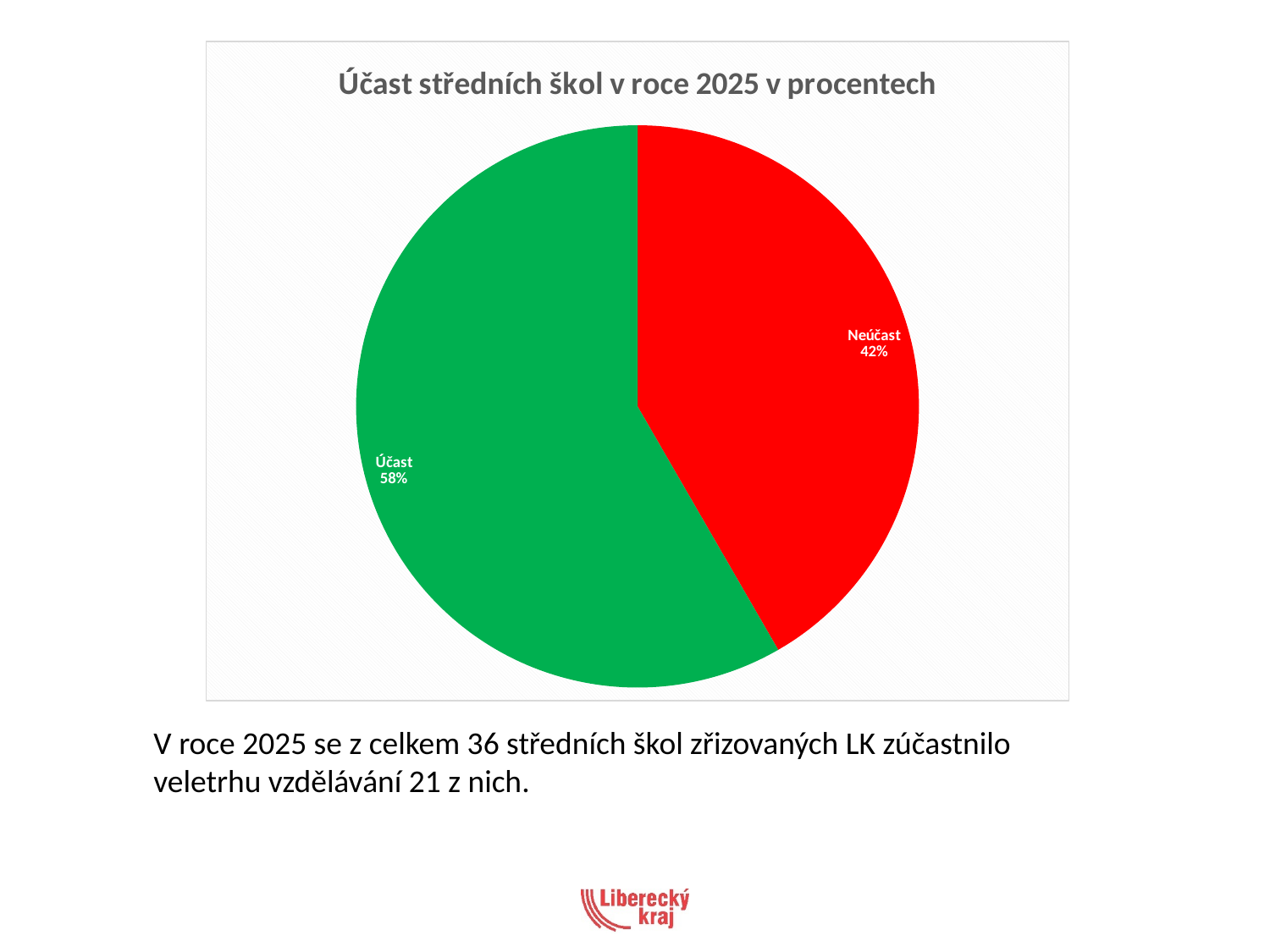
What colour is the Účast slice? green What share of the pie does the Účast slice represent? 58% Which is larger, the Účast slice or the Neúčast slice? Účast What is the difference in percentage points between the Účast and Neúčast slices? 16 How many slices does the pie chart have? 2 What share of the pie does the Neúčast slice represent? 42% Which slice is the largest in the pie chart? Účast What kind of chart is shown on the slide? pie chart Which slice is the smallest in the pie chart? Neúčast Is the value for Neúčast greater or less than 50%? less What is the title of the chart? Účast středních škol v roce 2025 v procentech